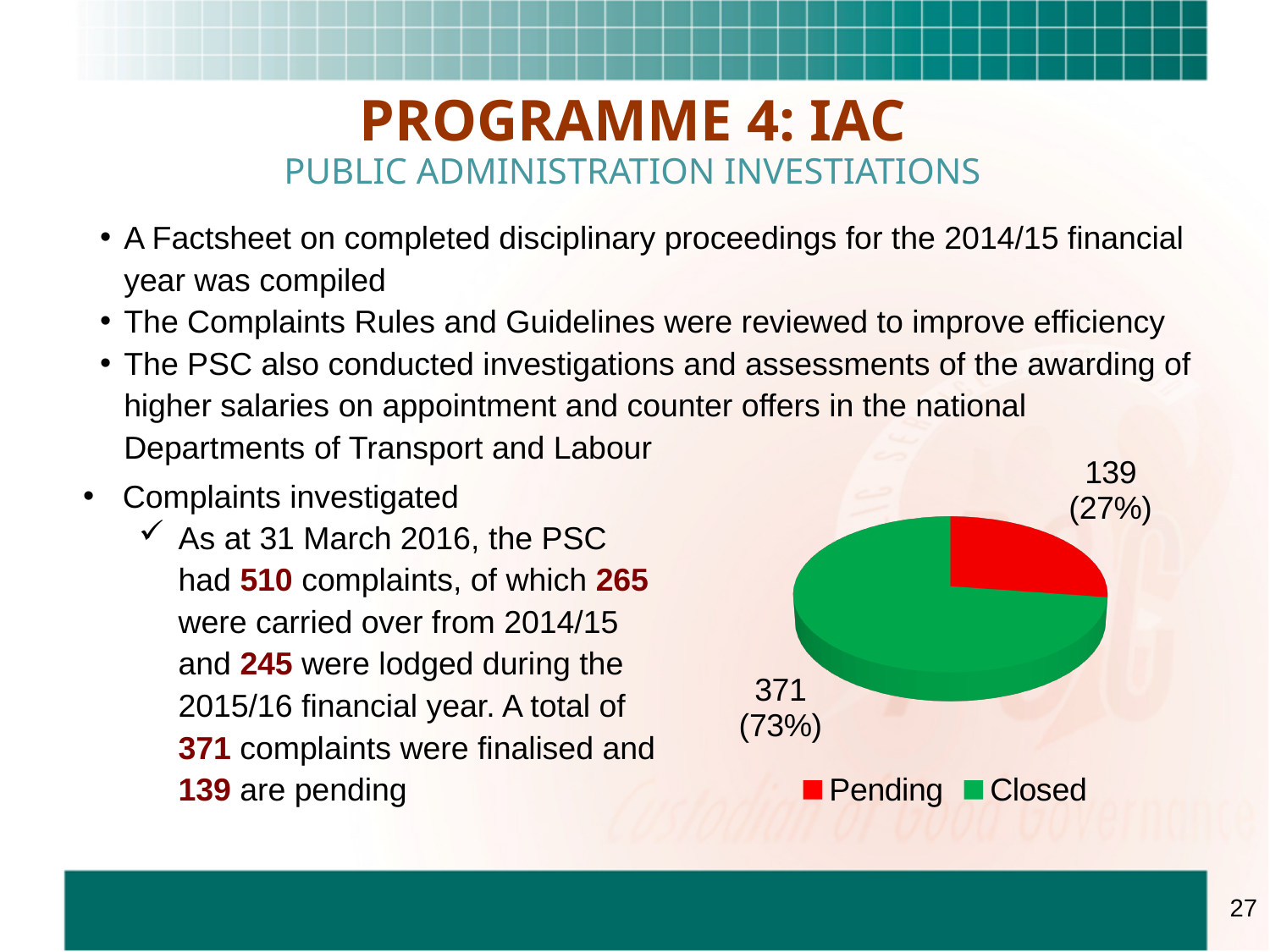
How many complaints are shown as Pending in the pie chart? 139 What is the total number of complaints represented in the pie chart? 510 How many complaints are shown as Closed in the pie chart? 371 How many categories does the pie chart show? 2 Which category has the largest slice in the pie chart? Closed What percentage of complaints does the Pending slice represent? 27% Which is larger, the Pending slice or the Closed slice? Closed What colour is the Pending slice in the pie chart? red What kind of chart is shown on the slide? pie chart Which category has the smallest slice in the pie chart? Pending What percentage of complaints does the Closed slice represent? 73% What is the difference between the number of Closed and Pending complaints? 232